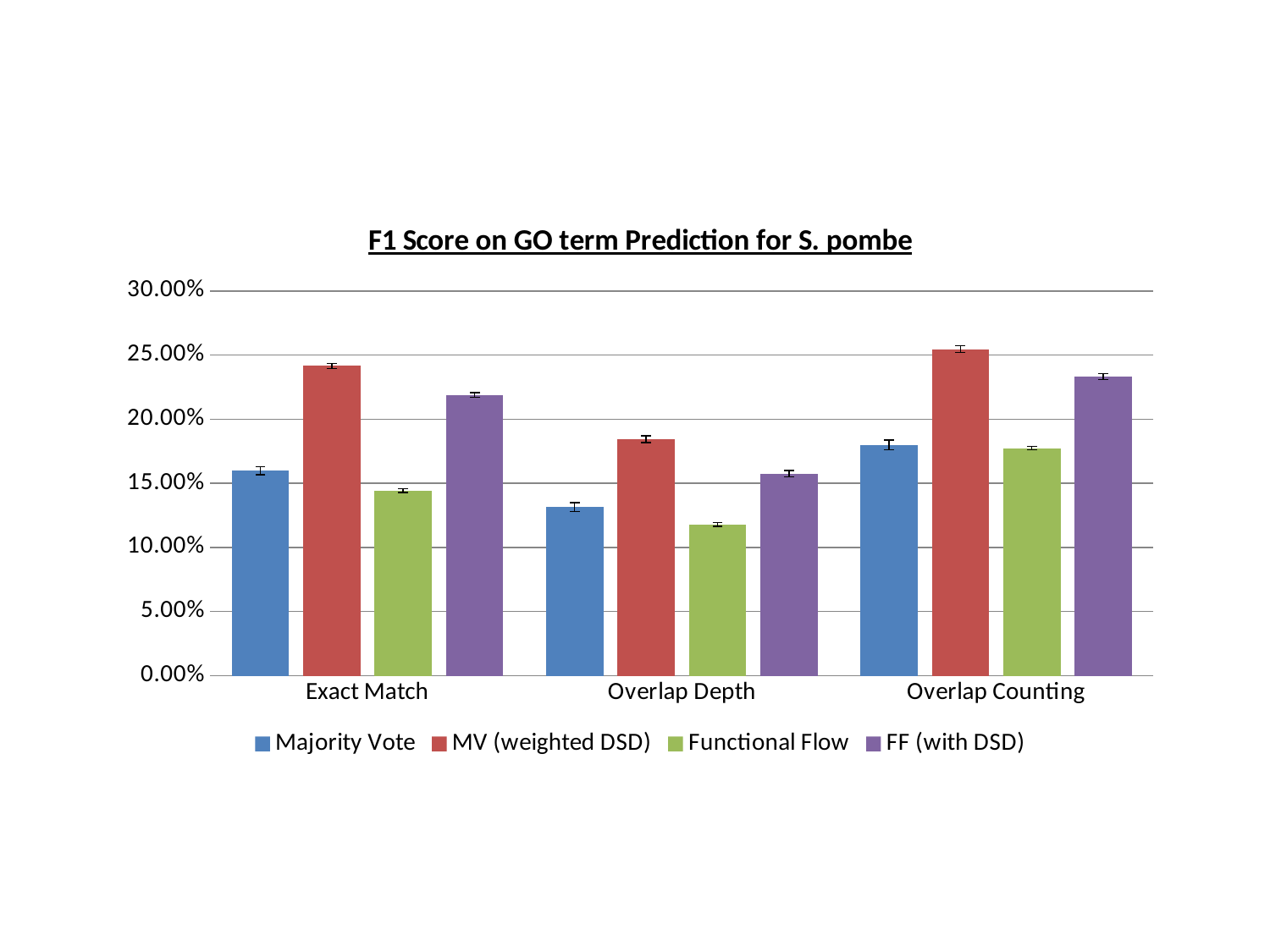
Is the value for FF (with DSD) in Overlap Counting greater or less than 20.00%? greater How many categories are shown on the x axis? 3 Which category has the highest bar for MV (weighted DSD)? Overlap Counting What is the title of the chart? F1 Score on GO term Prediction for S. pombe How many series does the legend list? 4 Is the value for Functional Flow in Exact Match greater or less than 15.00%? less Which colour represents the Functional Flow series? green Is the value for Majority Vote in Overlap Depth greater or less than 15.00%? less Which series has the lowest bar in the Overlap Depth category? Functional Flow In the Exact Match category, which is larger: Majority Vote or FF (with DSD)? FF (with DSD) What kind of chart is shown on the slide? bar chart Which series has the highest bar in the Exact Match category? MV (weighted DSD)